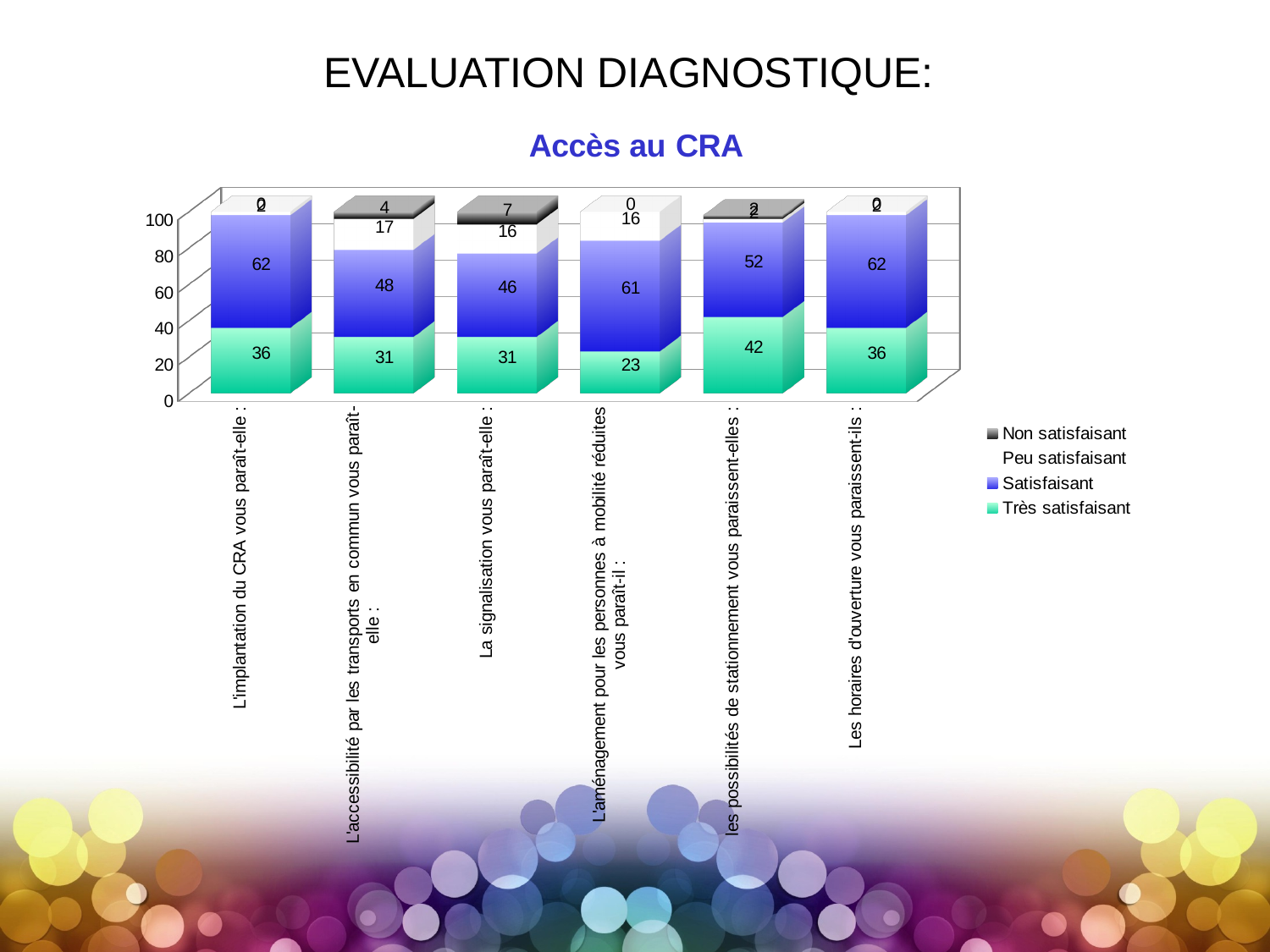
What is the 'Non satisfaisant' value for 'La signalisation vous paraît-elle :'? 7 What is the 'Peu satisfaisant' value for 'L'accessibilité par les transports en commun vous paraît-elle :'? 17 Which category has the lowest 'Très satisfaisant' value? L'aménagement pour les personnes à mobilité réduites vous paraît-il : What is the total of the stacked bar for 'La signalisation vous paraît-elle :'? 100 What type of chart is shown on the slide? bar chart Which category has the highest 'Très satisfaisant' value? les possibilités de stationnement vous paraissent-elles : What is the 'Très satisfaisant' value for 'les possibilités de stationnement vous paraissent-elles :'? 42 What is the title of the chart? Accès au CRA How many categories are shown on the x axis? 6 What is the difference between the 'Satisfaisant' and 'Très satisfaisant' values for 'L'implantation du CRA vous paraît-elle :'? 26 How many series does the legend list? 4 What is the 'Satisfaisant' value for 'L'aménagement pour les personnes à mobilité réduites vous paraît-il :'? 61